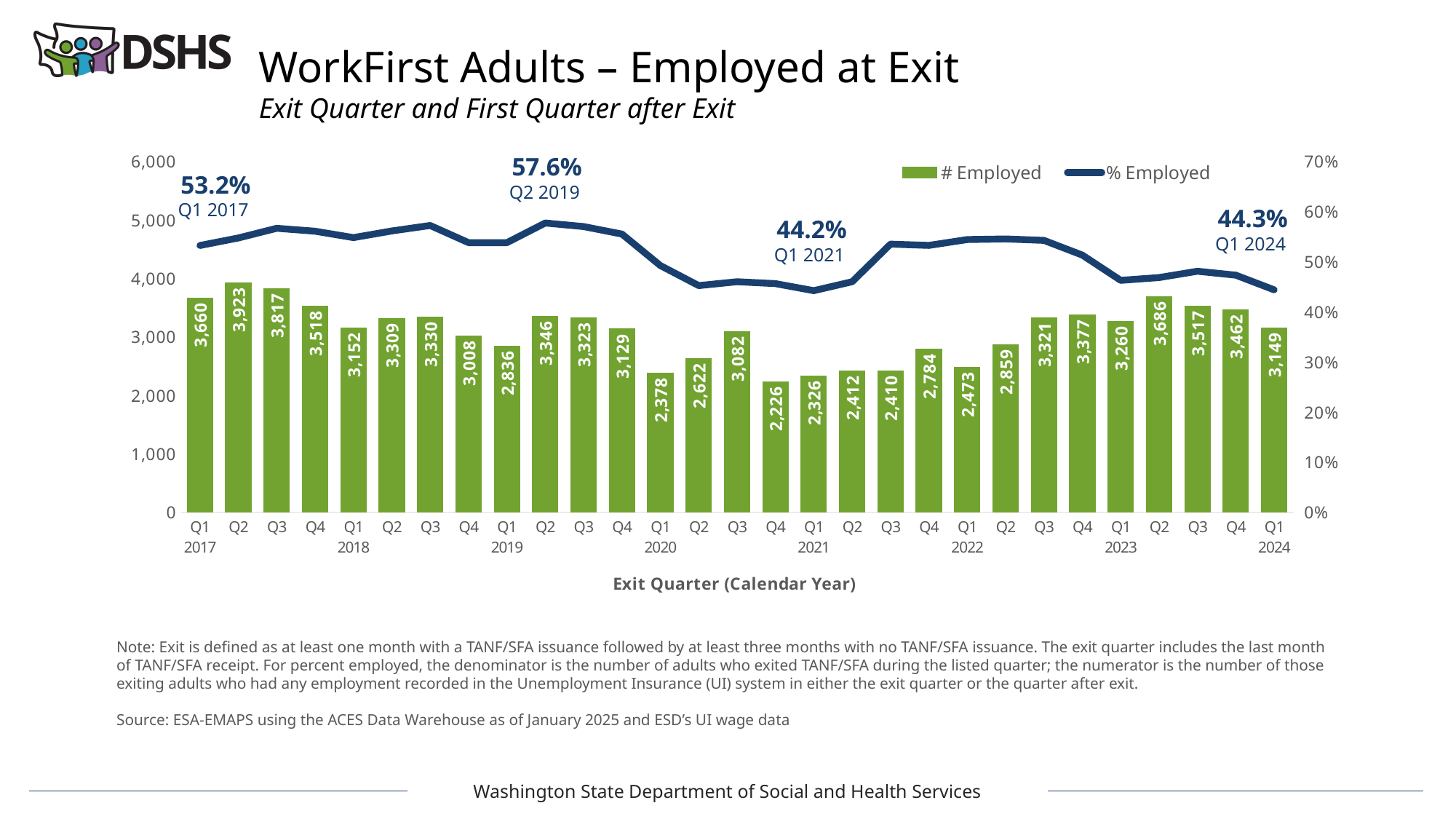
What is the # Employed value for Q4 2020? 2,226 Is the % Employed value for Q2 2020 greater or less than 50%? less How many series does the legend list? 2 How many quarters are plotted on the x axis? 29 How many adults were employed at exit in Q2 2017? 3,923 What is the % Employed value labeled for Q1 2024? 44.3% Which is larger, the # Employed in Q2 2023 or in Q1 2024? Q2 2023 What is the x-axis title of the chart? Exit Quarter (Calendar Year) What is the difference in # Employed between Q2 2017 and Q4 2020? 1,697 Which quarter has the highest number employed? Q2 2017 What percent of WorkFirst adults were employed at exit in Q2 2019? 57.6% Which quarter has the lowest number employed? Q4 2020